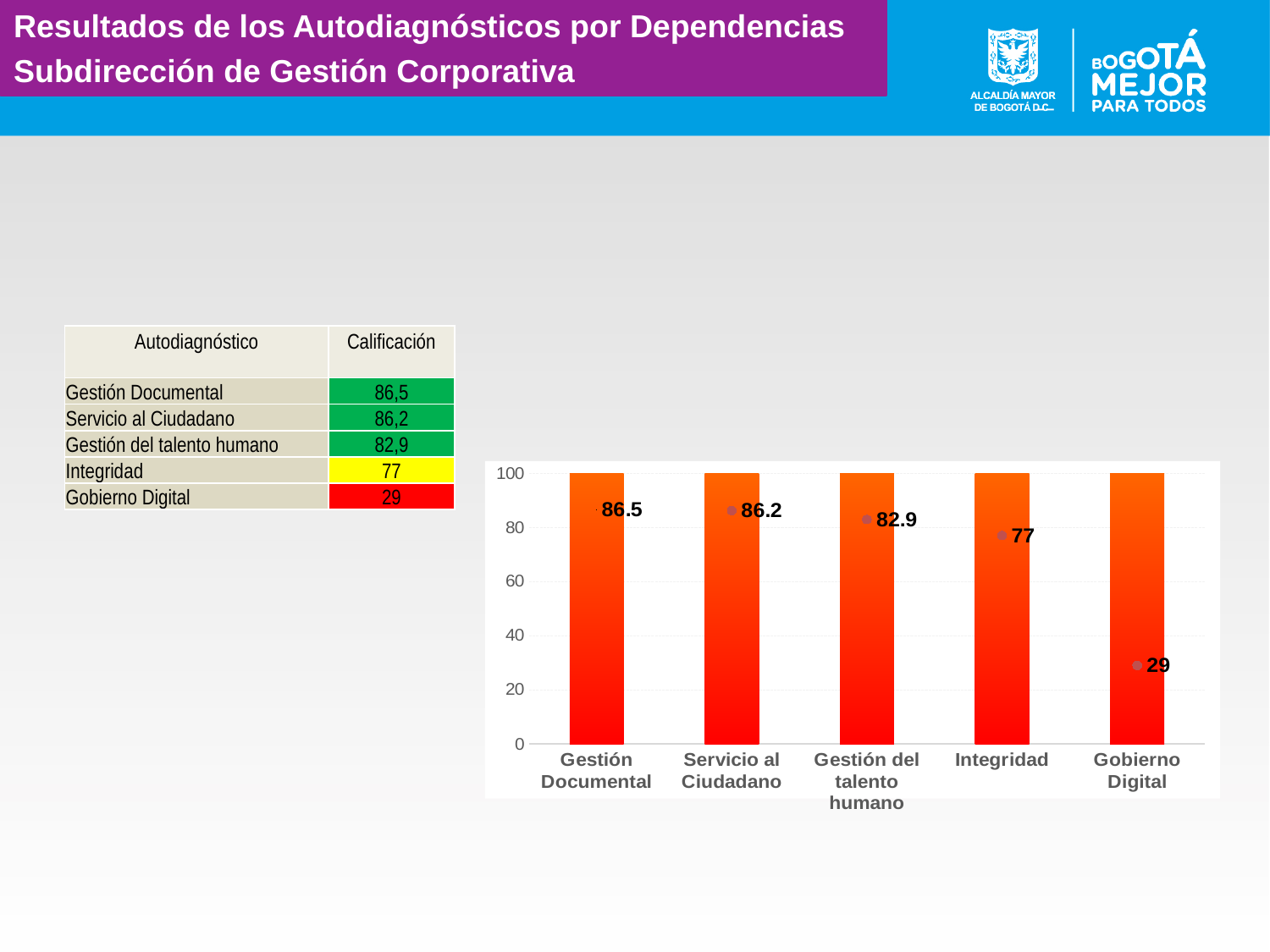
What value is labelled for Gestión del talento humano in the chart? 82.9 Do the labelled values rise or fall from left to right along the x axis? fall What value is labelled for Gestión Documental in the chart? 86.5 What is the difference between the labelled values for Integridad and Gobierno Digital? 48 Which has the larger labelled value, Gestión del talento humano or Integridad? Gestión del talento humano Is the labelled value for Gobierno Digital greater or less than 40? less Which category has the highest labelled value in the chart? Gestión Documental What value is labelled for Gobierno Digital in the chart? 29 What value is labelled for Integridad in the chart? 77 What is the difference between the labelled values for Gestión Documental and Gestión del talento humano? 3.6 How many categories are shown on the x axis of the chart? 5 Which category has the lowest labelled value in the chart? Gobierno Digital